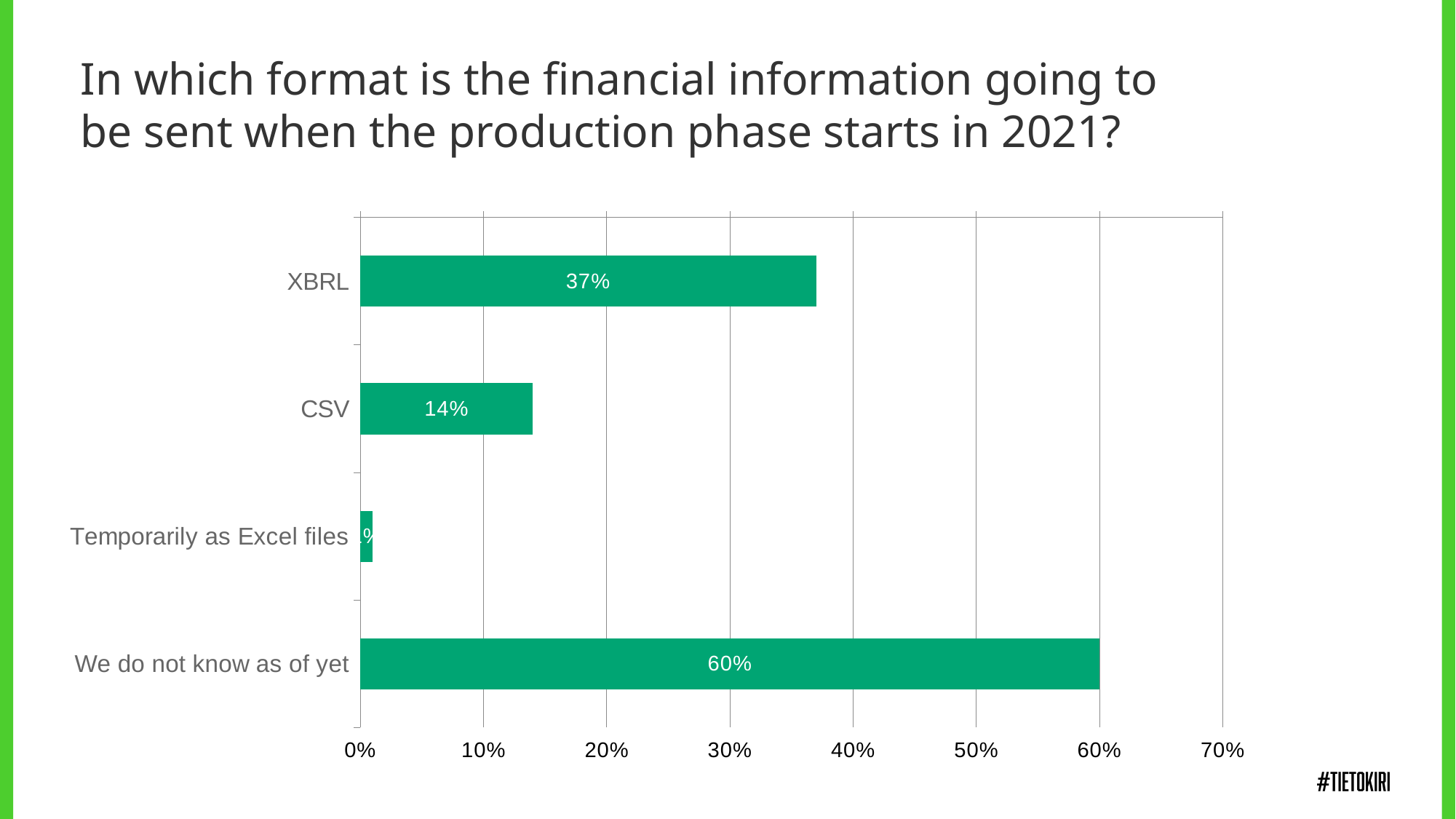
What is the difference between the values for XBRL and CSV? 23% Which is larger, the value for XBRL or the value for CSV? XBRL Is the value for "Temporarily as Excel files" greater or less than 10%? less Which category has the highest value? We do not know as of yet What kind of chart is shown on the slide? Bar chart What is the maximum value shown on the horizontal axis? 70% How many categories are shown in the chart? 4 Which category has the lowest value? Temporarily as Excel files What is the value for CSV? 14% What percentage of respondents chose XBRL? 37% What is the value for "We do not know as of yet"? 60% What is the difference between the values for "We do not know as of yet" and XBRL? 23%